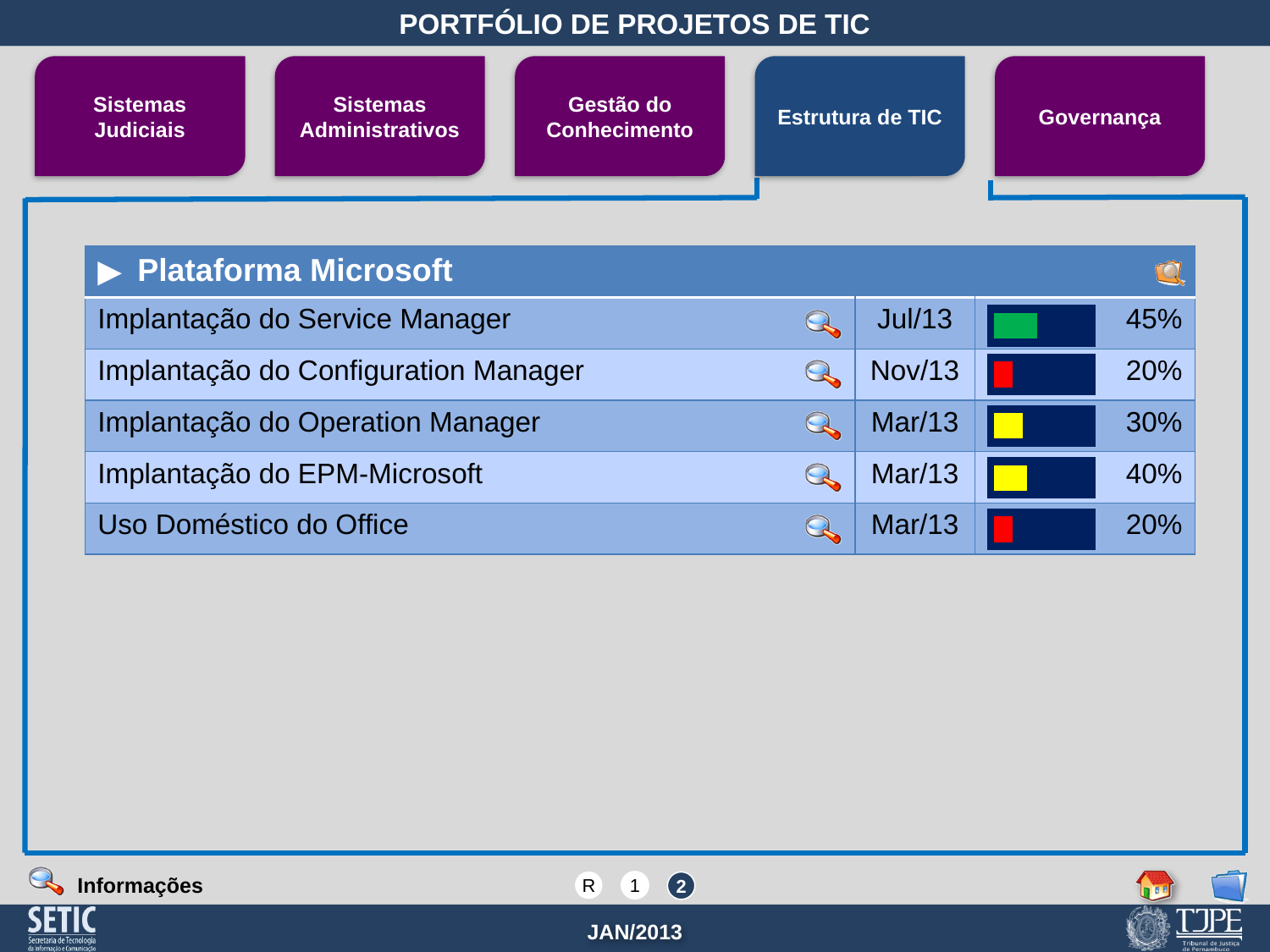
What is the lowest progress percentage shown in the Plataforma Microsoft table? 20% What is the target date shown for Implantação do Configuration Manager? Nov/13 What is the progress percentage shown for Implantação do Configuration Manager? 20% Which project in the Plataforma Microsoft table has the highest progress percentage? Implantação do Service Manager What is the difference between the progress of Implantação do EPM-Microsoft and Uso Doméstico do Office? 20% Which has a higher progress percentage, Implantação do EPM-Microsoft or Implantação do Operation Manager? Implantação do EPM-Microsoft What is the difference between the progress of Implantação do Service Manager and Implantação do Operation Manager? 15% What is the progress percentage shown for Implantação do Service Manager? 45% What is the progress percentage shown for Implantação do Operation Manager? 30% What is the progress percentage shown for Implantação do EPM-Microsoft? 40% What colour is the progress bar for Implantação do Service Manager? Green How many projects are listed in the Plataforma Microsoft table? 5